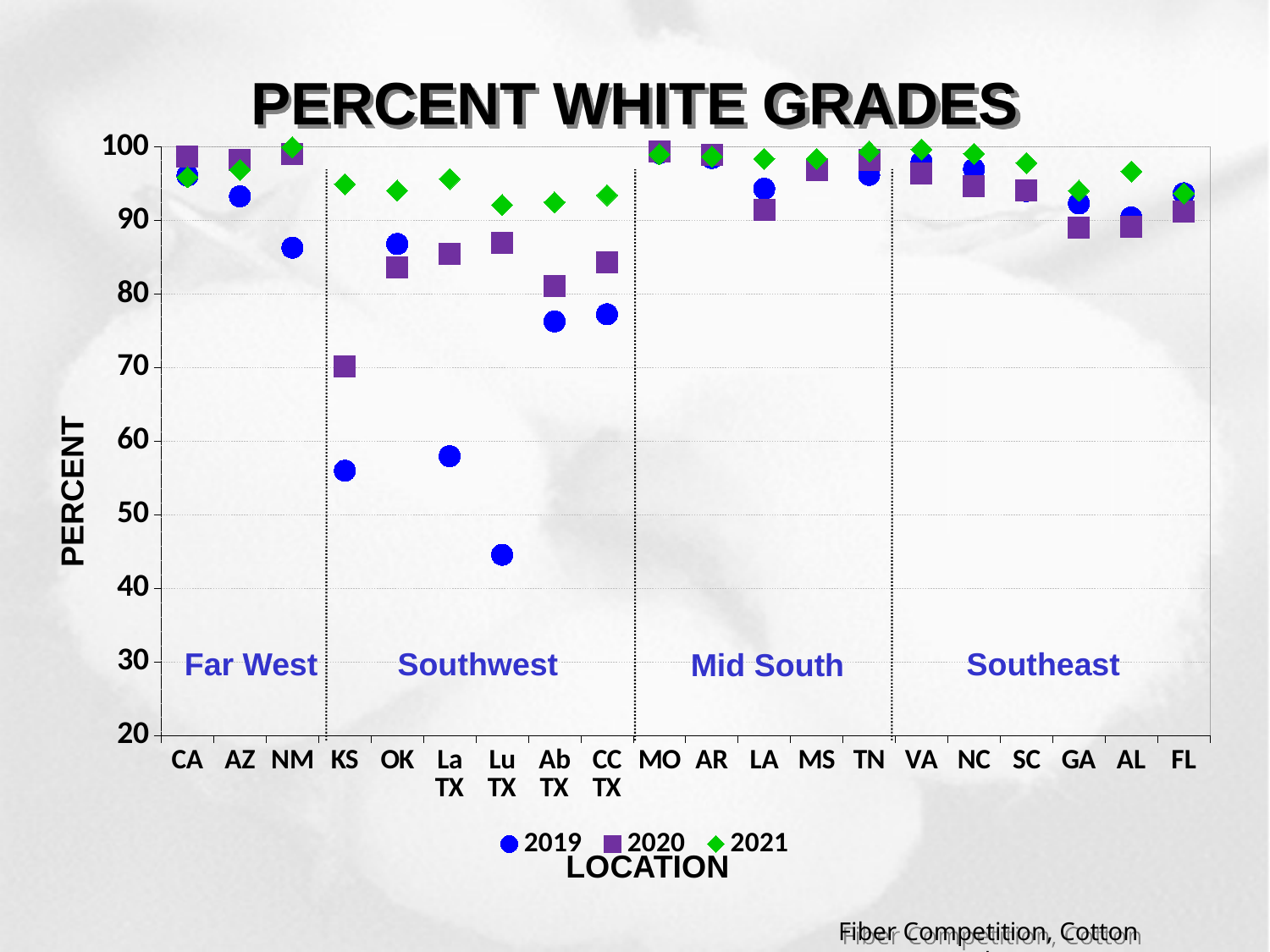
Is the 2019 value for Ab TX greater or less than 80? less Is the 2020 value for KS greater or less than 80? less Is the 2021 value for KS greater or less than 90? greater How many series does the legend list? 3 Which location has the lowest 2020 value? KS At KS, which series has the larger value, 2019 or 2020? 2020 How many locations are plotted along the x axis? 20 What is the title of the chart? PERCENT WHITE GRADES Which location has the lowest 2019 value? Lu TX What kind of chart is shown on the slide? scatter chart